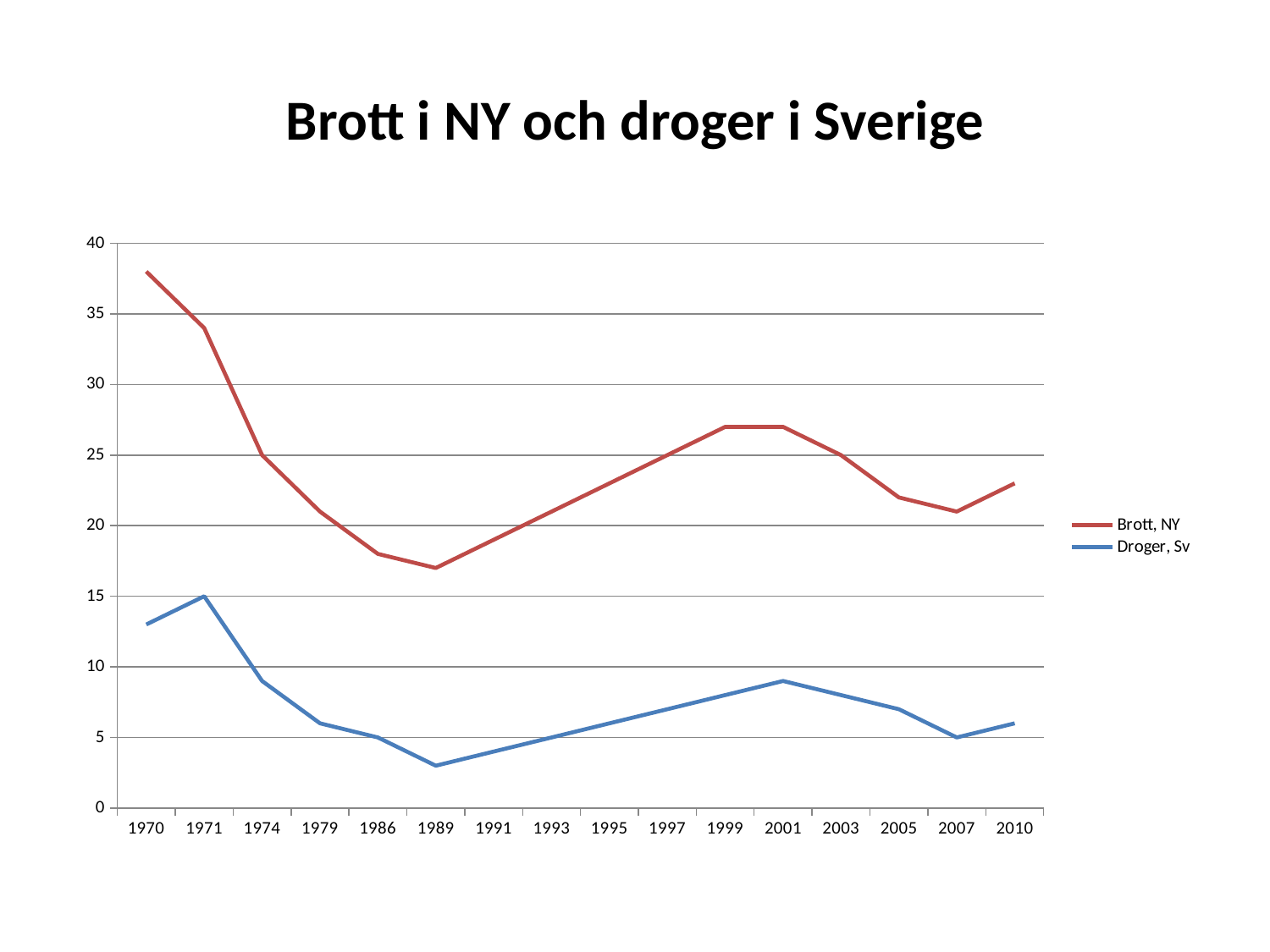
What kind of chart is shown on the slide? line chart What is the value for Droger, Sv in 2007? 5 How many years are shown on the x axis? 16 In which year is Brott, NY highest? 1970 What is the value for Droger, Sv in 1971? 15 How many series does the legend list? 2 Is the value for Brott, NY in 1970 greater or less than 35? greater In which year is Droger, Sv lowest? 1989 Does Brott, NY rise or fall from 1970 to 1989? fall What is the value for Brott, NY in 1974? 25 Which series has the larger value in 1970, Brott, NY or Droger, Sv? Brott, NY Is the value for Droger, Sv in 1989 greater or less than 5? less